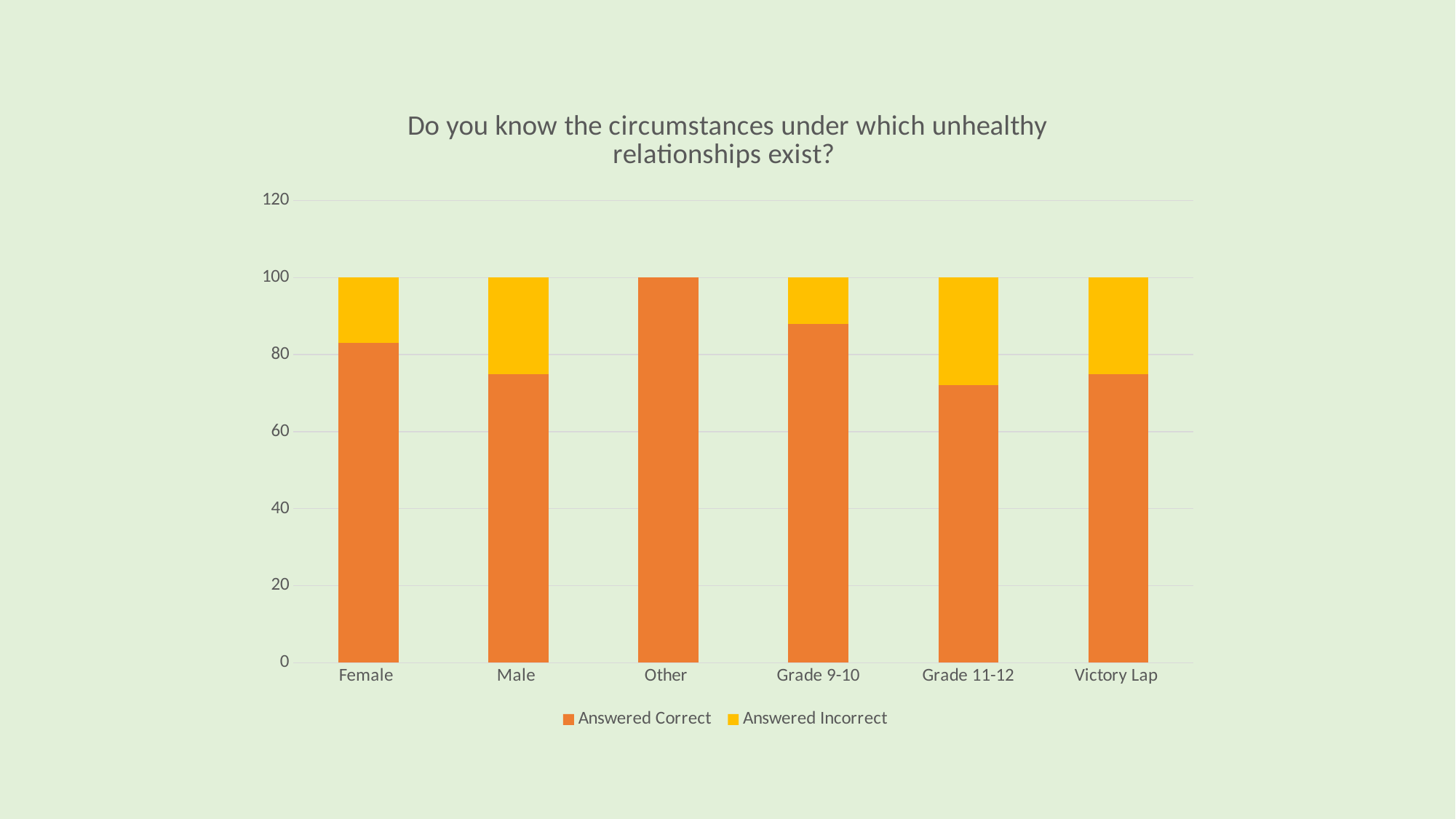
What kind of chart is shown on the slide? Stacked bar chart Is the Answered Correct value for Grade 9-10 greater or less than 80? greater Is the Answered Correct value for Female greater or less than 80? greater What is the Answered Correct value for Other? 100 How many categories are shown on the x axis? 6 What is the title of the chart? Do you know the circumstances under which unhealthy relationships exist? Which category has the highest Answered Correct value? Other Which has the larger Answered Correct value, Female or Male? Female Is the Answered Correct value for Male greater or less than 80? less Which has the larger Answered Incorrect value, Grade 9-10 or Grade 11-12? Grade 11-12 What is the total height of the stacked bar for Female? 100 How many series does the legend list? 2